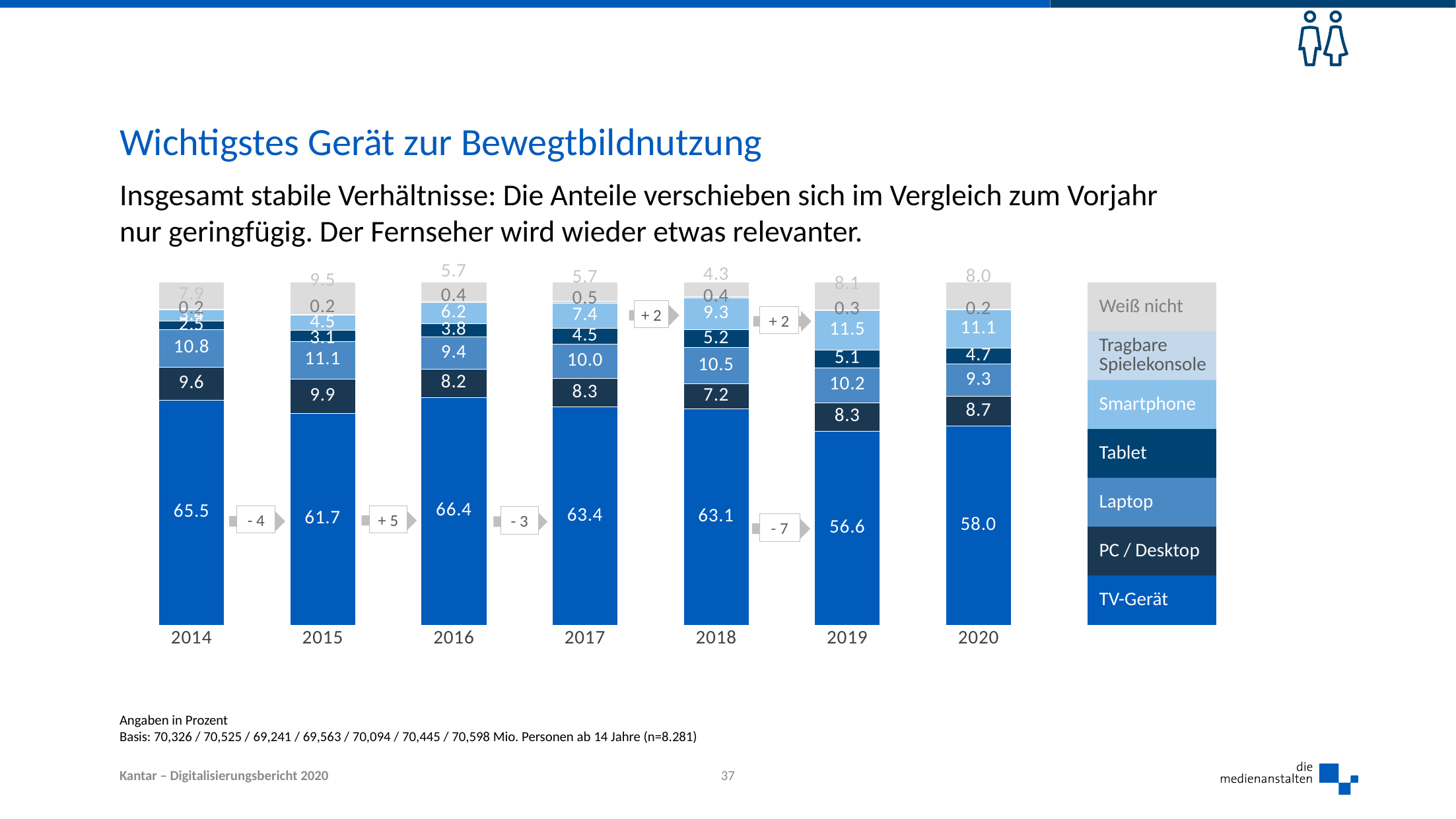
What is the Weiß nicht value in 2018? 4.3 What is the value for TV-Gerät in 2020? 58.0 What is the Smartphone value in 2019? 11.5 What is the difference between the TV-Gerät values in 2020 and 2019? 1.4 How many series does the legend list? 7 What kind of chart is shown on the slide? Stacked bar chart Which is larger in 2017: the Laptop value or the Smartphone value? Laptop How many years are shown on the x axis? 7 In which year is the TV-Gerät value lowest? 2019 In which year is the TV-Gerät value highest? 2016 Does the Smartphone value rise or fall from 2015 to 2019? Rise What is the Laptop value in 2015? 11.1